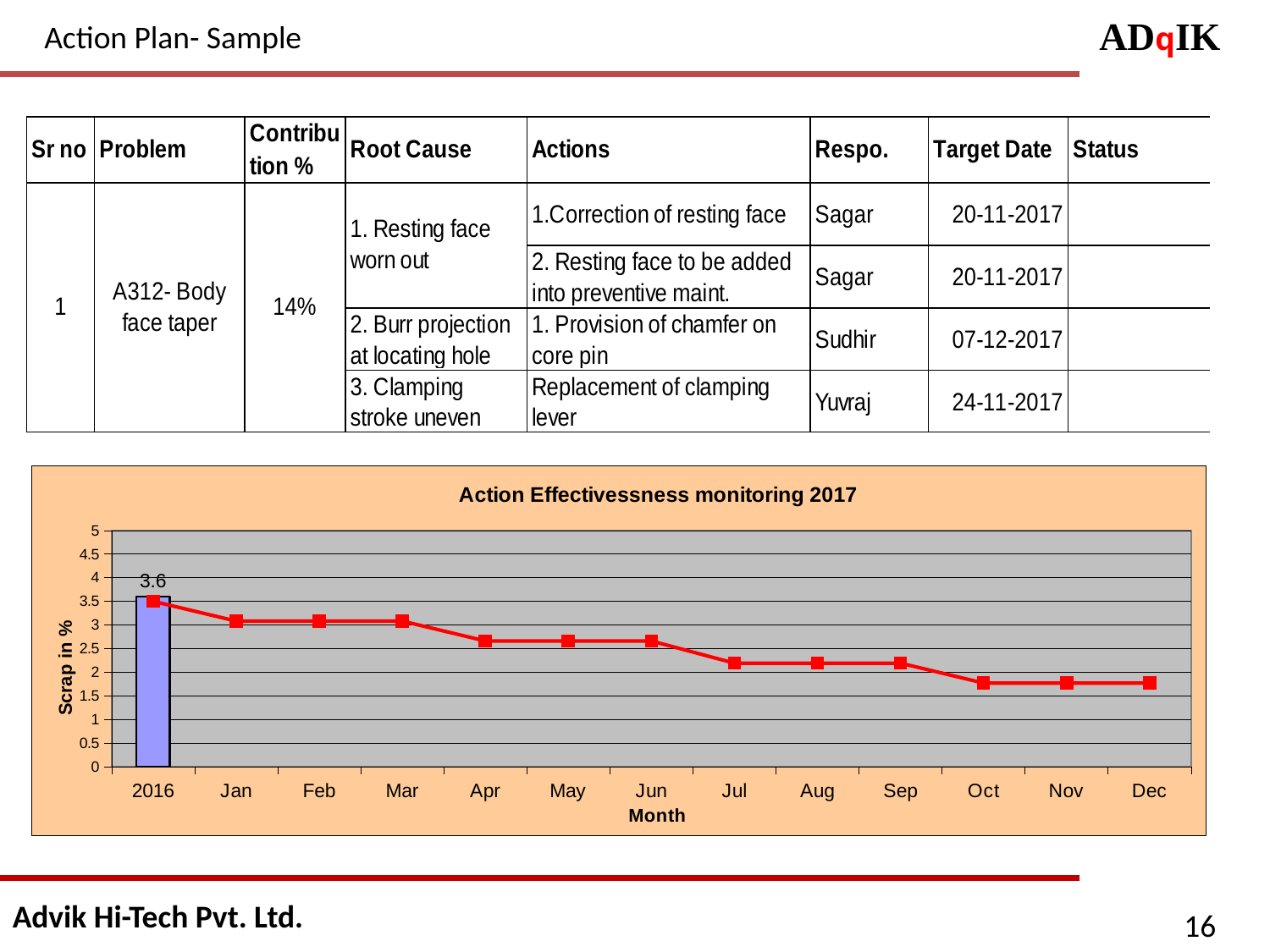
Is the value for May greater or less than 2.5 in the Action Effectivessness monitoring 2017 chart? greater What is the title of the chart on the slide? Action Effectivessness monitoring 2017 Is the value for Dec greater or less than 2 in the Action Effectivessness monitoring 2017 chart? less Which is larger in the Action Effectivessness monitoring 2017 chart, the value for Feb or the value for Nov? Feb How many categories are shown on the x axis of the Action Effectivessness monitoring 2017 chart? 13 Is the value for Jul greater or less than 2.5 in the Action Effectivessness monitoring 2017 chart? less Do the scrap values rise or fall from Jan to Dec in the Action Effectivessness monitoring 2017 chart? fall What is the label of the vertical axis in the Action Effectivessness monitoring 2017 chart? Scrap in % What is the value printed for 2016 in the Action Effectivessness monitoring 2017 chart? 3.6 Which category has the highest scrap value in the Action Effectivessness monitoring 2017 chart? 2016